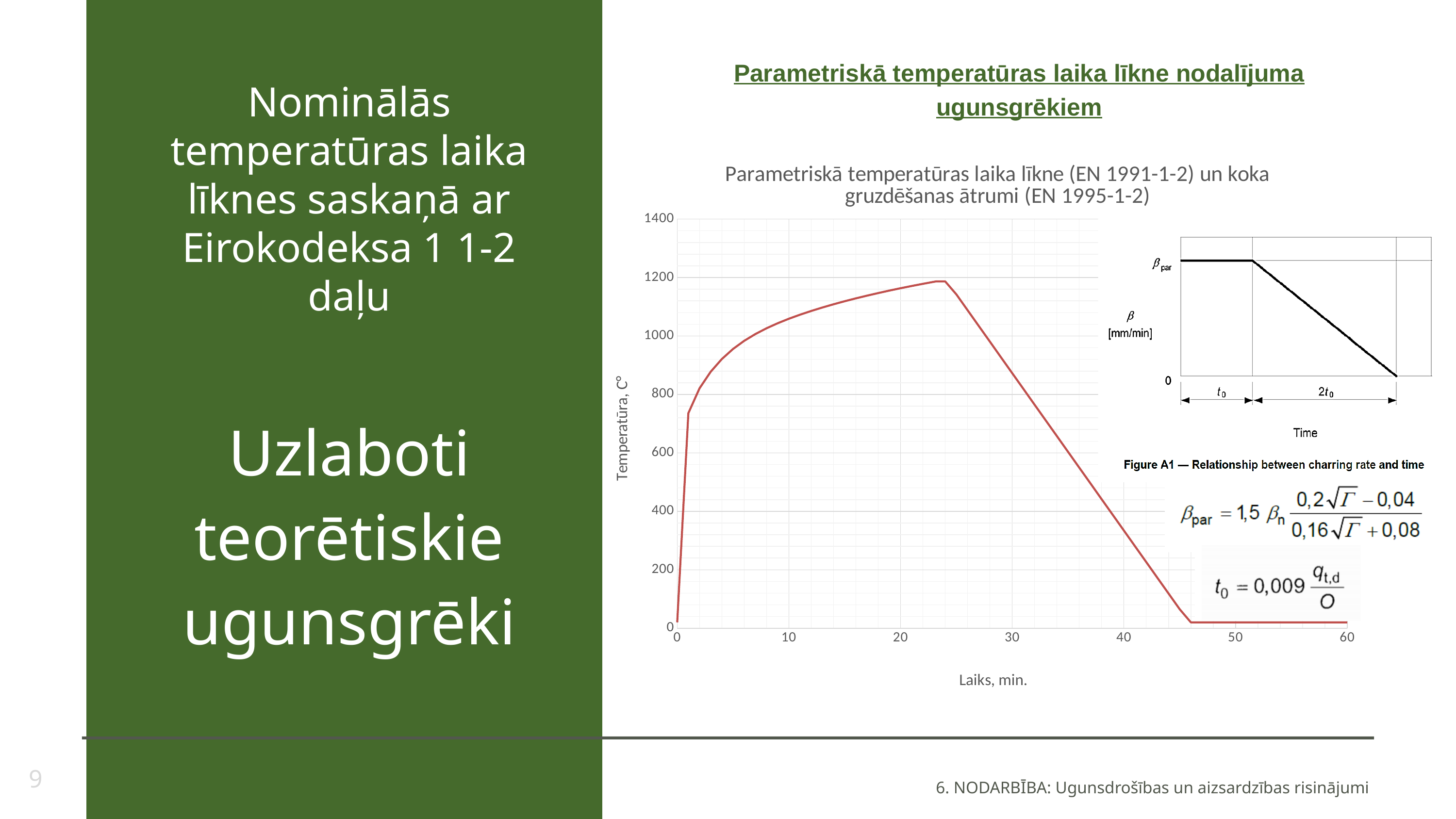
Is the temperature at 30 minutes greater or less than 600? greater Between 30 and 40 minutes, does the temperature rise or fall? fall Between 0 and 20 minutes, does the temperature rise or fall? rise Is the temperature at 50 minutes greater or less than 200? less Is the peak temperature of the curve greater or less than 1000? greater What kind of chart is shown on the slide? line chart What is the label of the vertical axis of the chart? Temperatūra, C° What is the title of the chart on the slide? Parametriskā temperatūras laika līkne (EN 1991-1-2) un koka gruzdēšanas ātrumi (EN 1995-1-2) What is the highest value shown on the horizontal (time) axis of the chart? 60